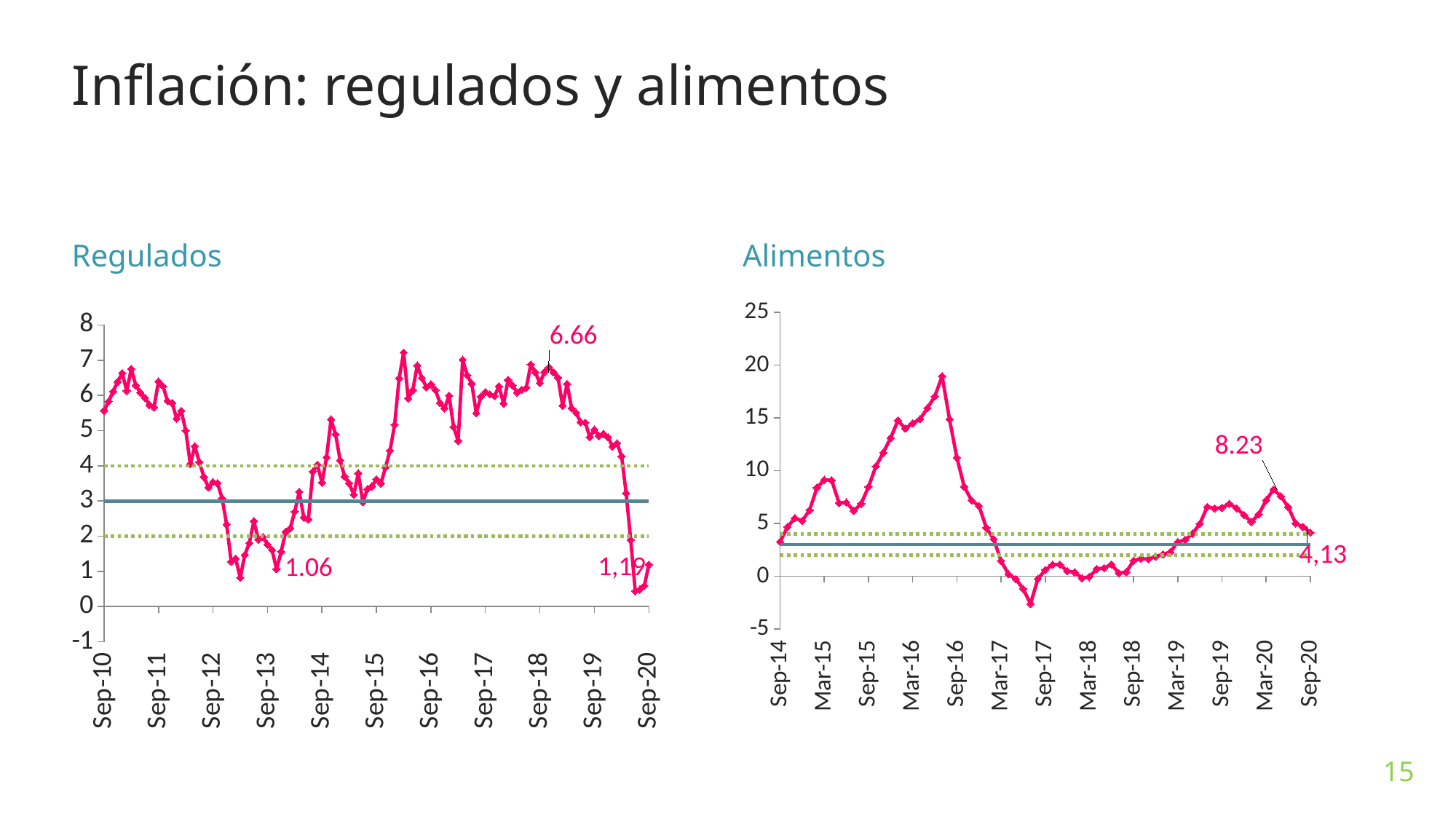
What kind of chart is the Regulados chart? line chart In the Regulados chart, what is the labelled peak value near Sep-18? 6.66 In the Alimentos chart, what is the labelled value at Sep-20? 4,13 In the Regulados chart, which labelled value is larger: the one near Sep-18 or the one at Sep-20? the one near Sep-18 (6.66) In the Regulados chart, what is the labelled low value near Sep-13? 1.06 In the Regulados chart, what is the labelled value at Sep-20? 1.19 In the Regulados chart, at what level is the solid horizontal reference line drawn? 3 In the Alimentos chart, what is the difference between the labelled values 8.23 and 4.13? 4.10 In the Alimentos chart, is the value at Mar-16 greater or less than 10? greater In the Regulados chart, what is the difference between the labelled values 6.66 and 1.06? 5.60 In the Alimentos chart, what is the labelled value near Mar-20? 8.23